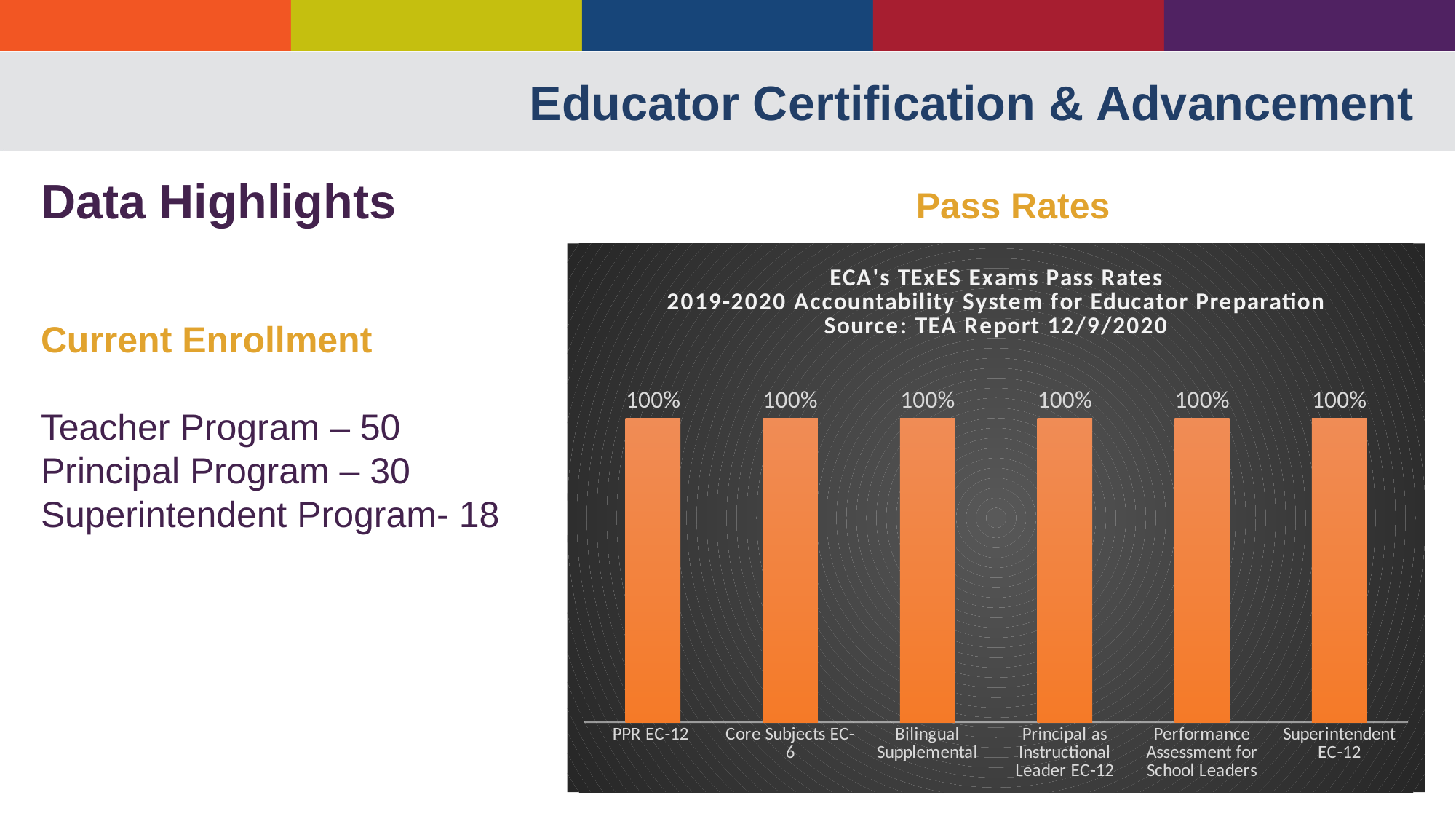
What is the difference between the pass rates for Core Subjects EC-6 and PPR EC-12? 0% What is the source cited in the chart title? TEA Report 12/9/2020 How many exam categories are shown in the chart? 6 What is the pass rate for Principal as Instructional Leader EC-12? 100% Do the pass rates rise, fall, or stay the same across the categories from left to right? Stay the same Is the pass rate for Core Subjects EC-6 greater or less than 50%? greater What is the pass rate for Bilingual Supplemental? 100% What is the pass rate for Performance Assessment for School Leaders? 100% What is the pass rate for Superintendent EC-12? 100% What is the pass rate for PPR EC-12? 100% What kind of chart is shown on the slide? Bar chart What colour are the bars in the chart? Orange